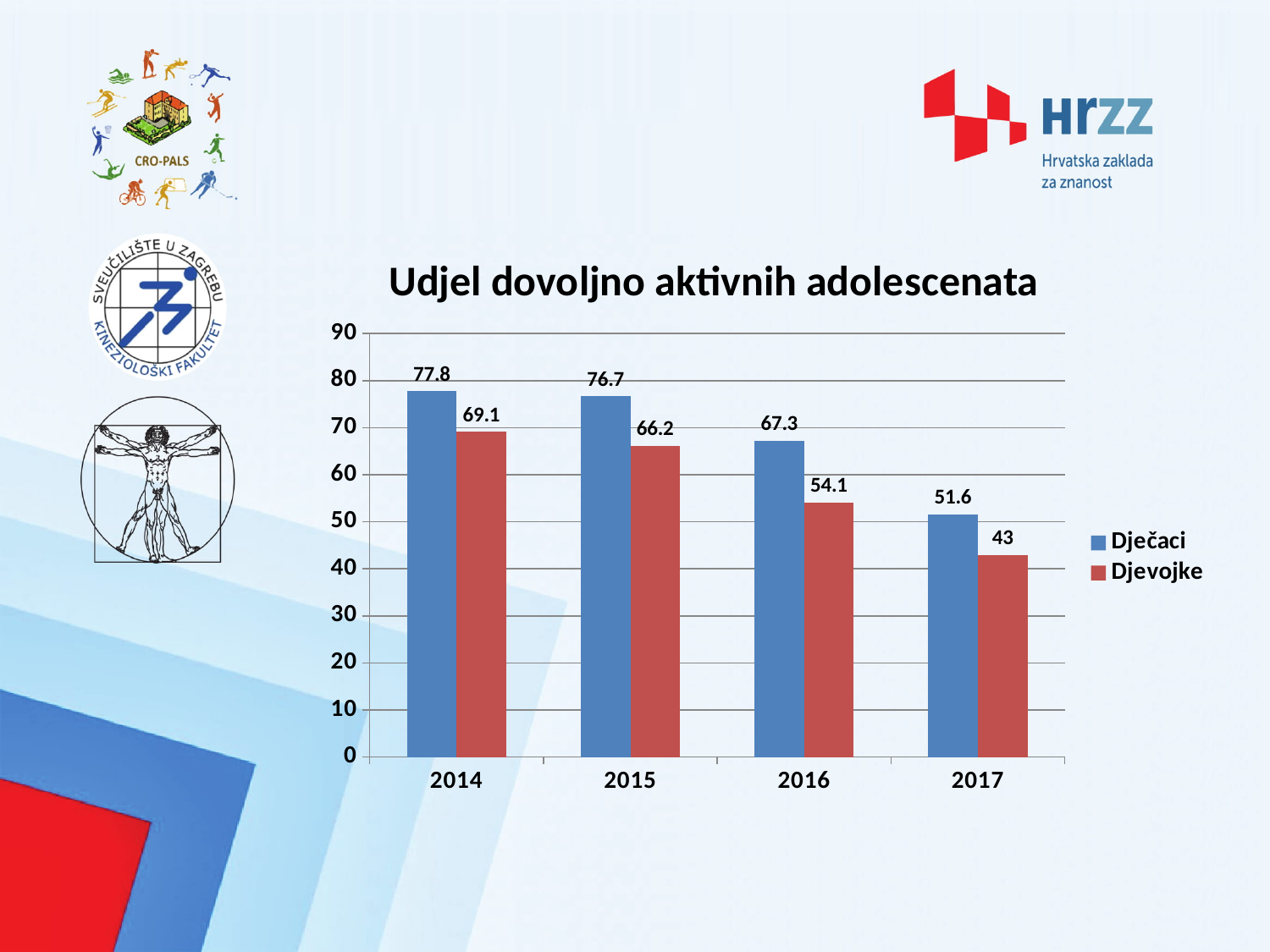
Which is larger in 2016, the Dječaci value or the Djevojke value? Dječaci How many series does the legend list? 2 What kind of chart is shown on the slide? Bar chart In which year is the Dječaci value lowest? 2017 What is the value for Djevojke in 2017? 43 What is the value for Djevojke in 2016? 54.1 How many years are shown on the x axis? 4 What is the value for Dječaci in 2014? 77.8 What is the difference between the Dječaci values in 2016 and 2017? 15.7 What is the difference between the Dječaci and Djevojke values in 2015? 10.5 In which year is the Djevojke value highest? 2014 Do the Djevojke values rise or fall from 2014 to 2017? Fall